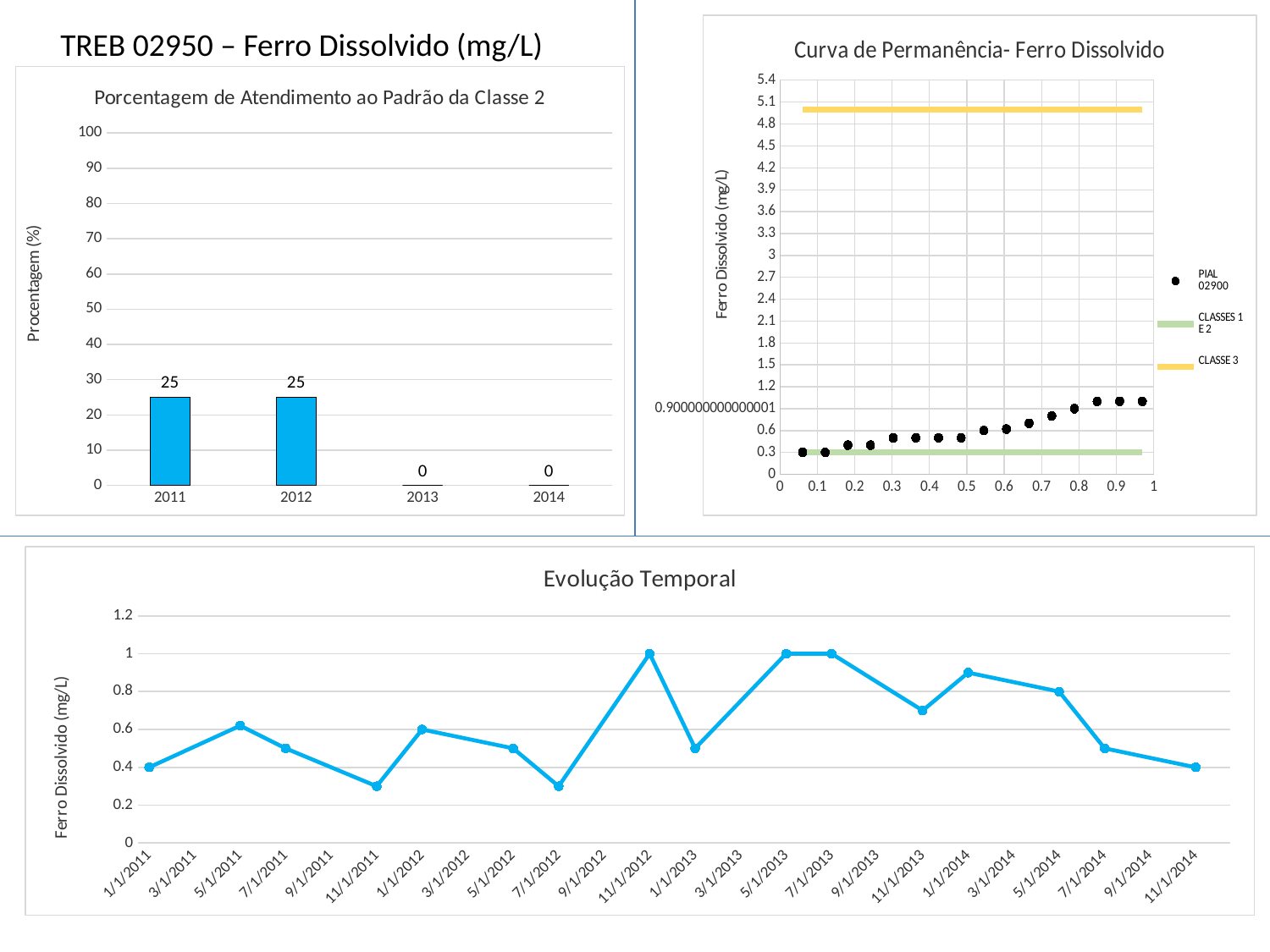
In the 'Porcentagem de Atendimento ao Padrão da Classe 2' chart, what is the difference between the values for 2012 and 2014? 25 In the 'Porcentagem de Atendimento ao Padrão da Classe 2' chart, how many years are shown on the x axis? 4 In the 'Curva de Permanência- Ferro Dissolvido' chart, what colour is the CLASSE 3 line? yellow In the 'Curva de Permanência- Ferro Dissolvido' chart, is the CLASSE 3 line greater or less than 3? greater In the 'Porcentagem de Atendimento ao Padrão da Classe 2' chart, what is the value for 2013? 0 How many series does the legend of the 'Curva de Permanência- Ferro Dissolvido' chart list? 3 In the 'Evolução Temporal' chart, which is larger, the value for 5/1/2013 or the value for 7/1/2014? 5/1/2013 In the 'Porcentagem de Atendimento ao Padrão da Classe 2' chart, is the value for 2011 greater or less than 50? less In the 'Evolução Temporal' chart, what is the value for 11/1/2012? 1 What kind of chart is 'Porcentagem de Atendimento ao Padrão da Classe 2'? bar chart In the 'Porcentagem de Atendimento ao Padrão da Classe 2' chart, what is the value for 2011? 25 In the 'Evolução Temporal' chart, is the value for 11/1/2011 greater or less than 0.6? less